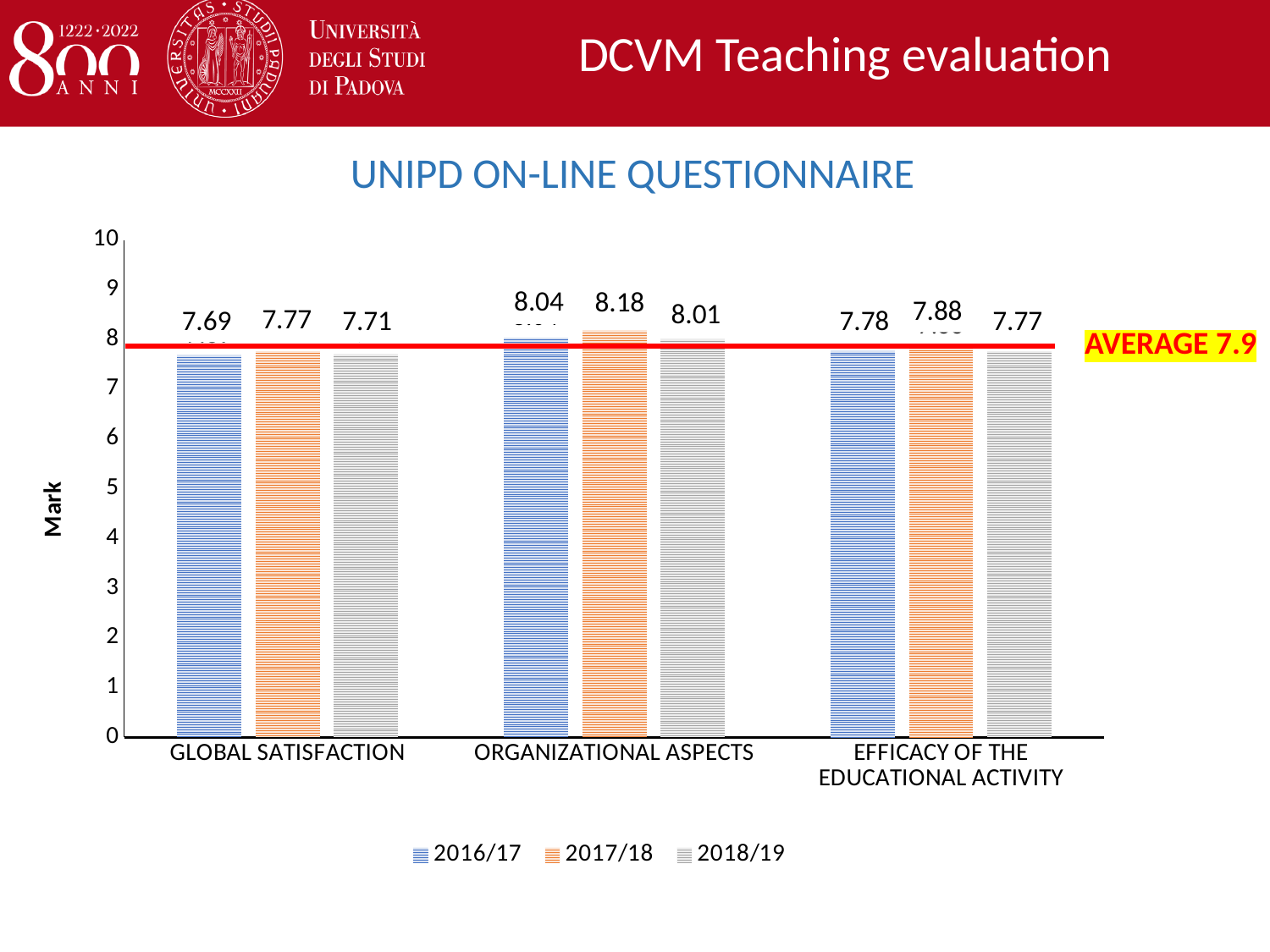
How many series does the legend list? 3 What average value is marked by the red horizontal line? 7.9 What is the value for Global Satisfaction in 2016/17? 7.69 What is the value for Organizational Aspects in 2017/18? 8.18 What is the label of the y axis? Mark Which is larger: the 2017/18 value for Global Satisfaction or the 2017/18 value for Efficacy of the Educational Activity? Efficacy of the Educational Activity Which category has the highest value in 2017/18? Organizational Aspects What is the value for Efficacy of the Educational Activity in 2018/19? 7.77 What kind of chart is shown on the slide? Bar chart What is the difference between the 2017/18 and 2016/17 values for Organizational Aspects? 0.14 Which category has the lowest value in 2016/17? Global Satisfaction How many categories are shown on the x axis? 3